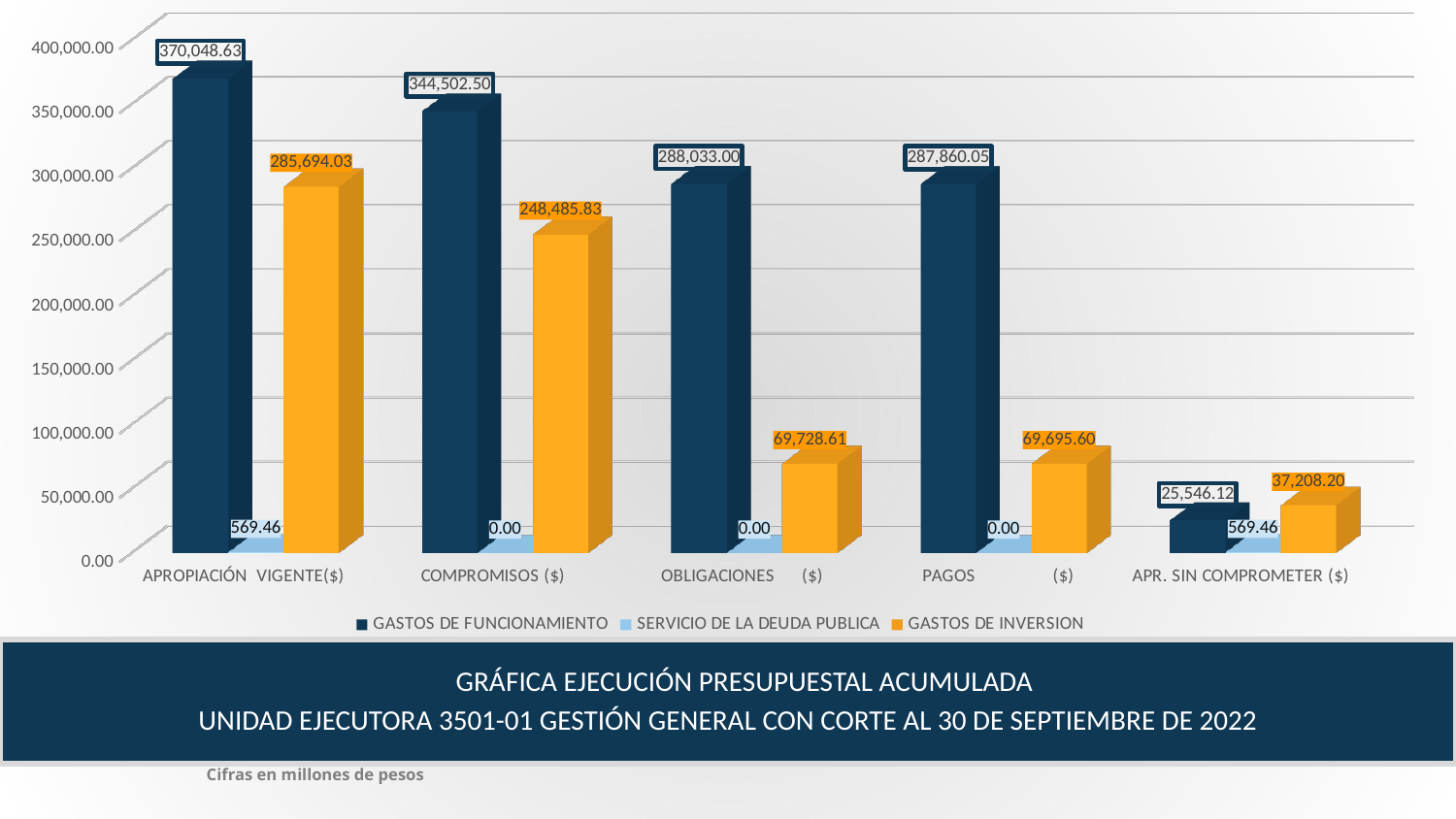
Which category has the highest value for GASTOS DE FUNCIONAMIENTO? APROPIACIÓN VIGENTE($) What is the value of GASTOS DE INVERSION for COMPROMISOS ($)? 248,485.83 How many series does the legend list? 3 How many categories are shown on the x axis? 5 What is the difference between GASTOS DE FUNCIONAMIENTO and GASTOS DE INVERSION for APROPIACIÓN VIGENTE($)? 84,354.60 Which category has the lowest value for GASTOS DE INVERSION? APR. SIN COMPROMETER ($) What is the value of GASTOS DE INVERSION for PAGOS ($)? 69,695.60 What is the value of SERVICIO DE LA DEUDA PUBLICA for APR. SIN COMPROMETER ($)? 569.46 What kind of chart is shown on the slide? Bar chart What is the value of GASTOS DE FUNCIONAMIENTO for APROPIACIÓN VIGENTE($)? 370,048.63 For APR. SIN COMPROMETER ($), which is larger: GASTOS DE FUNCIONAMIENTO or GASTOS DE INVERSION? GASTOS DE INVERSION Do the GASTOS DE FUNCIONAMIENTO values rise or fall from left to right across the categories? Fall